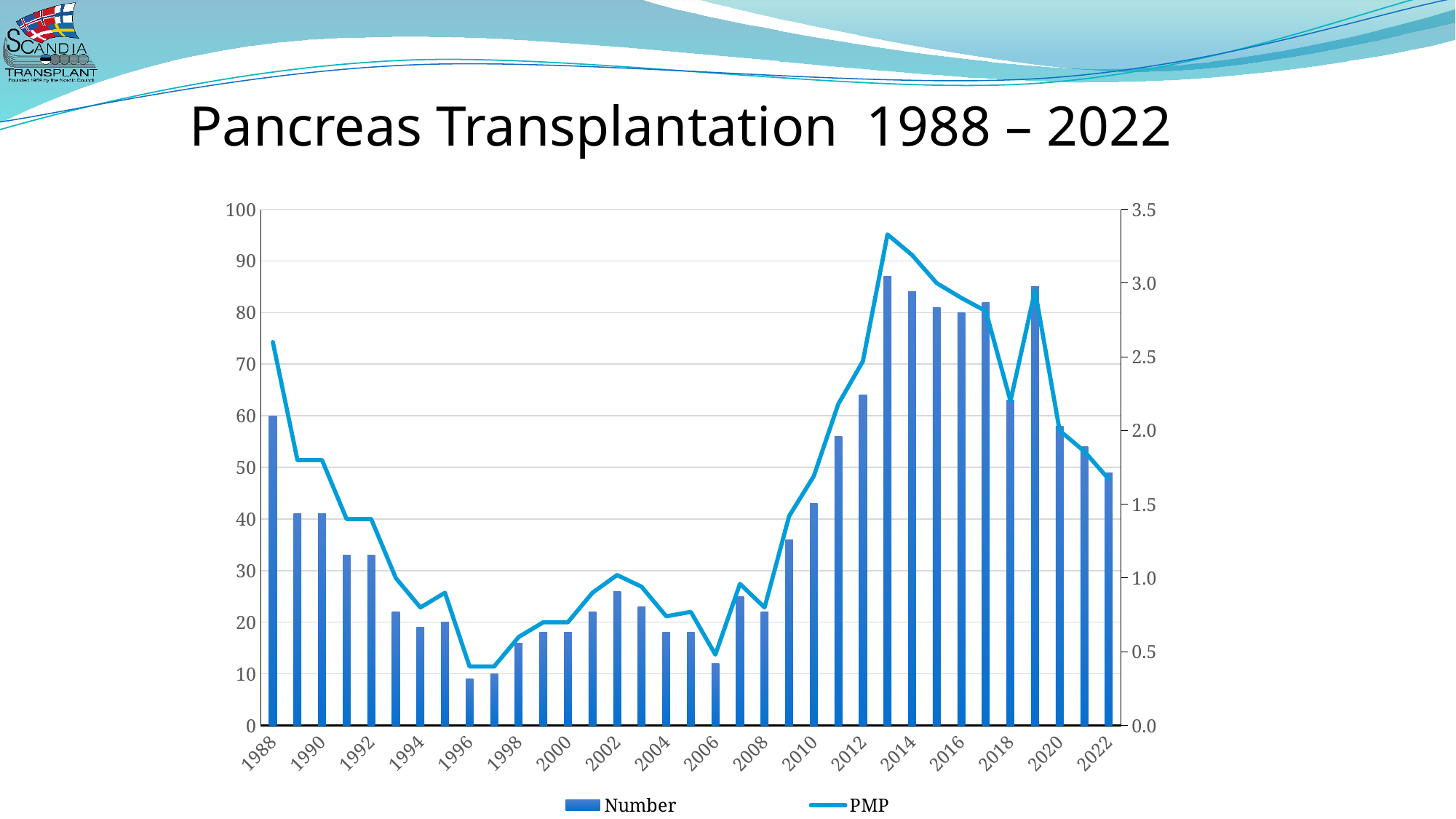
Is the Number for 2013 greater or less than 80? greater Does the Number of transplantations rise or fall from 2006 to 2013? rise What are the two series named in the legend? Number and PMP How many years (bars) are plotted on the chart? 35 Is the PMP value for 2013 greater or less than 3.0? greater How many series does the legend list? 2 What kind of chart is shown on the slide? Combined bar and line chart What is the Number of pancreas transplantations in 1988? 60 Which year has the lowest Number of pancreas transplantations? 1996 Which year has the highest Number of pancreas transplantations? 2013 Which year has the larger Number, 1988 or 1990? 1988